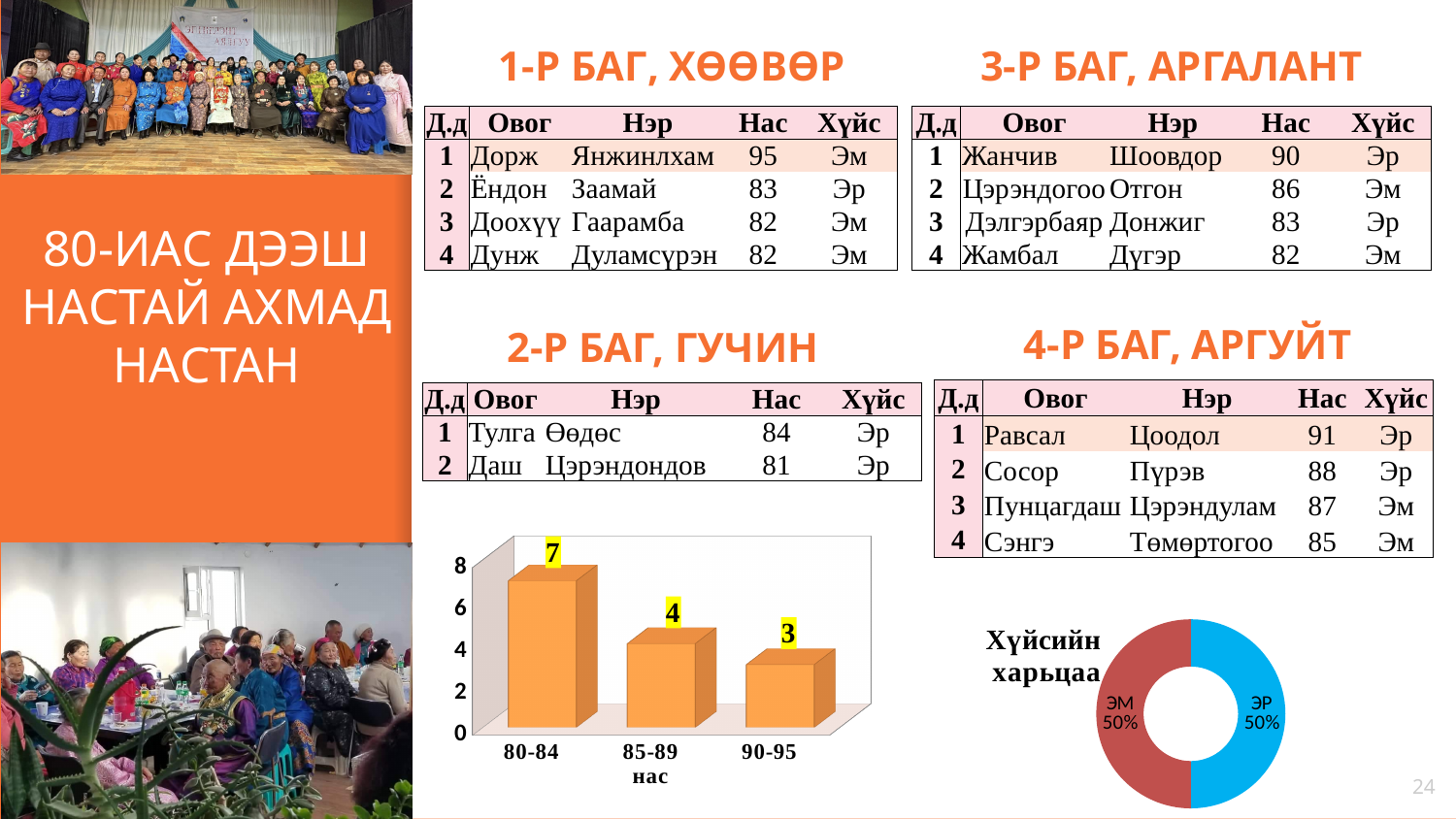
In the 'Хүйсийн харьцаа' chart at the bottom right, what share does ЭР have? 50% What is the x-axis title of the bar chart at the bottom centre? нас In the bar chart at the bottom centre, which age group has the highest value? 80-84 In the bar chart at the bottom centre, which is larger: the value for 85-89 or the value for 90-95? 85-89 In the bar chart at the bottom centre, what is the value for the 80-84 age group? 7 In the bar chart at the bottom centre, which age group has the lowest value? 90-95 In the bar chart at the bottom centre, what is the difference between the values for 80-84 and 90-95? 4 What kind of chart is the one at the bottom centre of the slide? bar chart In the bar chart at the bottom centre, what is the value for the 90-95 age group? 3 In the bar chart at the bottom centre, how many age-group categories are shown on the x axis? 3 In the bar chart at the bottom centre, do the values rise or fall from left to right along the x axis? fall In the bar chart at the bottom centre, what is the value for the 85-89 age group? 4